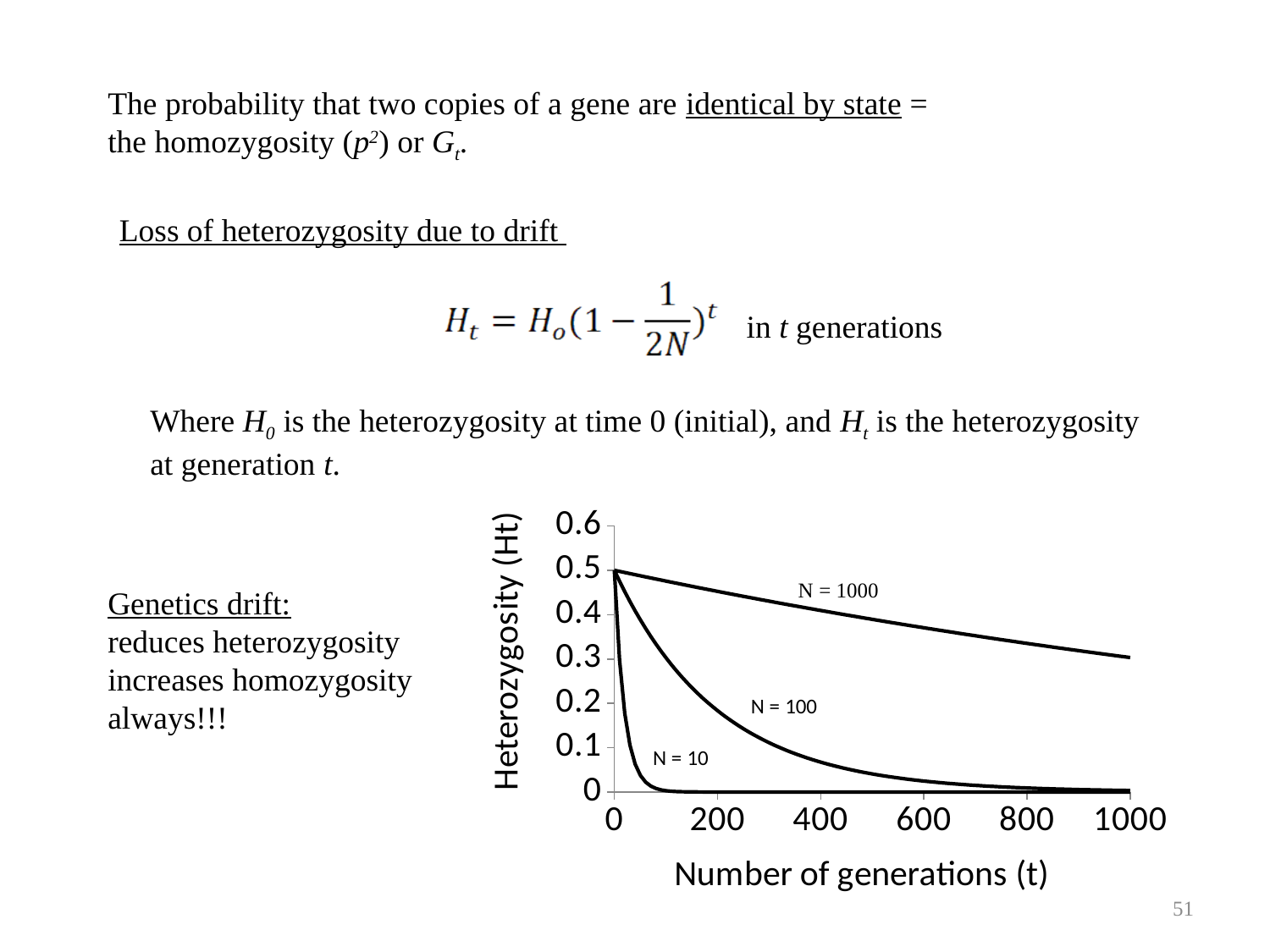
Is the heterozygosity for N = 10 at 200 generations greater or less than 0.1? less Do the heterozygosity values rise or fall as the number of generations increases? fall What kind of chart is shown on the slide? line chart How many curves (population sizes) are plotted on the chart? 3 Which curve drops to near zero heterozygosity fastest? N = 10 What is the title of the y axis of the chart? Heterozygosity (Ht) Is the heterozygosity for N = 1000 at 200 generations greater or less than 0.4? greater What is the heterozygosity value at generation 0 for all three curves? 0.5 What is the title of the x axis of the chart? Number of generations (t) At 400 generations, which curve has the larger heterozygosity, N = 1000 or N = 100? N = 1000 Which curve has the highest heterozygosity at 1000 generations? N = 1000 Is the heterozygosity for N = 100 at 400 generations greater or less than 0.1? less